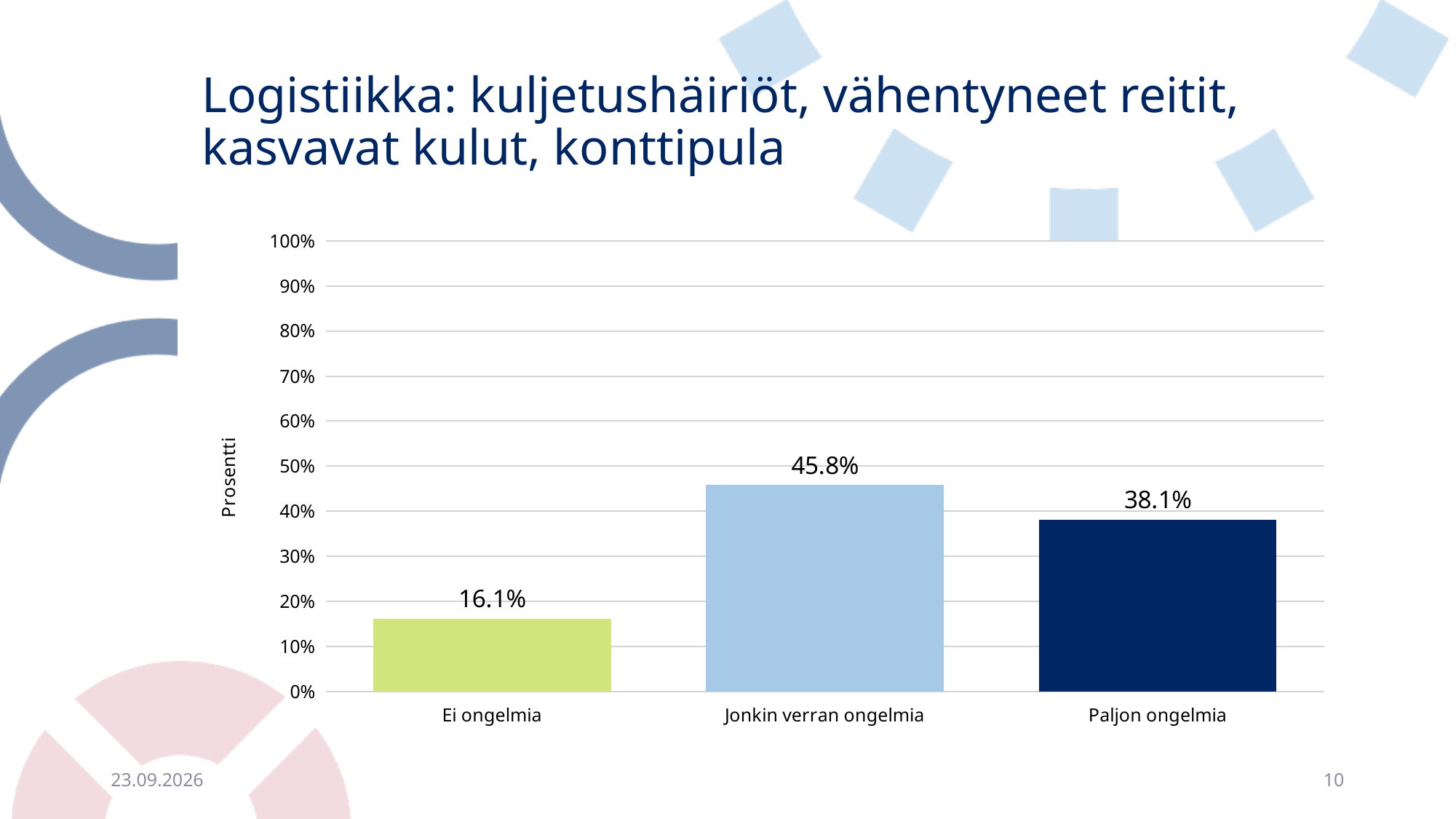
What is the value for Jonkin verran ongelmia? 45.8% What is the label of the vertical axis? Prosentti What is the difference between the values for Jonkin verran ongelmia and Paljon ongelmia? 7.7% Is the value for Jonkin verran ongelmia greater or less than 40%? greater How many categories are shown on the x axis? 3 What is the difference between the values for Paljon ongelmia and Ei ongelmia? 22.0% What kind of chart is shown on the slide? bar chart Which category has the lowest value? Ei ongelmia Which category has the highest value? Jonkin verran ongelmia Which is larger, the value for Ei ongelmia or the value for Paljon ongelmia? Paljon ongelmia What is the value for Paljon ongelmia? 38.1% What is the value for Ei ongelmia? 16.1%